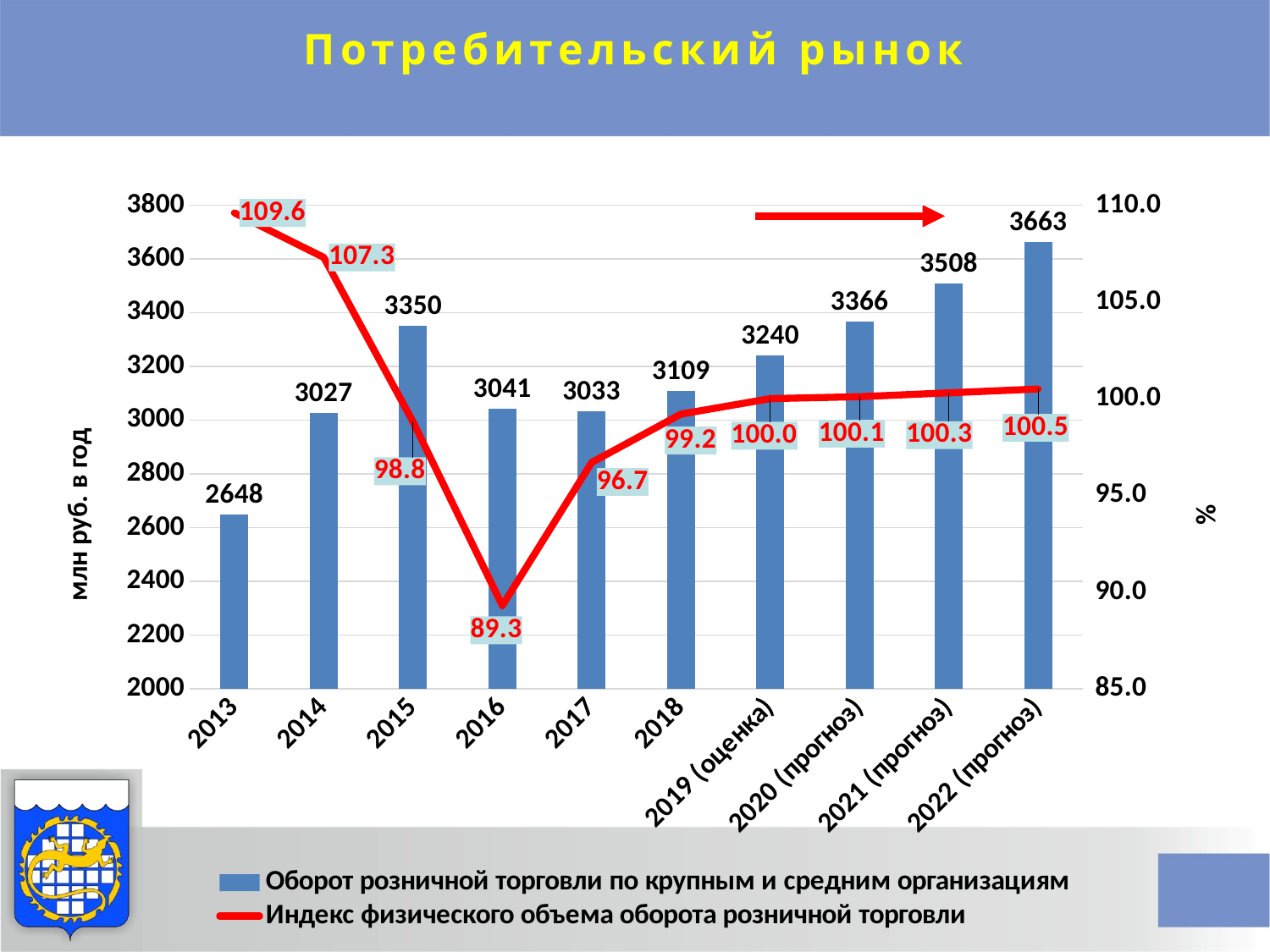
Which is larger, the retail turnover in 2016 or in 2017? 2016 What is the difference between the retail turnover in 2022 (прогноз) and in 2013? 1015 What is the retail turnover (Оборот розничной торговли) value for 2015? 3350 How many series does the legend list? 2 What is the retail turnover value for 2022 (прогноз)? 3663 What is the title of the slide? Потребительский рынок What kind of chart is shown on the slide? Combined bar and line chart What is the value of the physical volume index (Индекс физического объема) for 2016? 89.3 Which year has the highest value of the physical volume index line? 2013 Which year has the lowest retail turnover bar? 2013 Do the retail turnover bars rise or fall from 2017 to 2022 (прогноз)? Rise How many years (categories) are shown on the x axis? 10